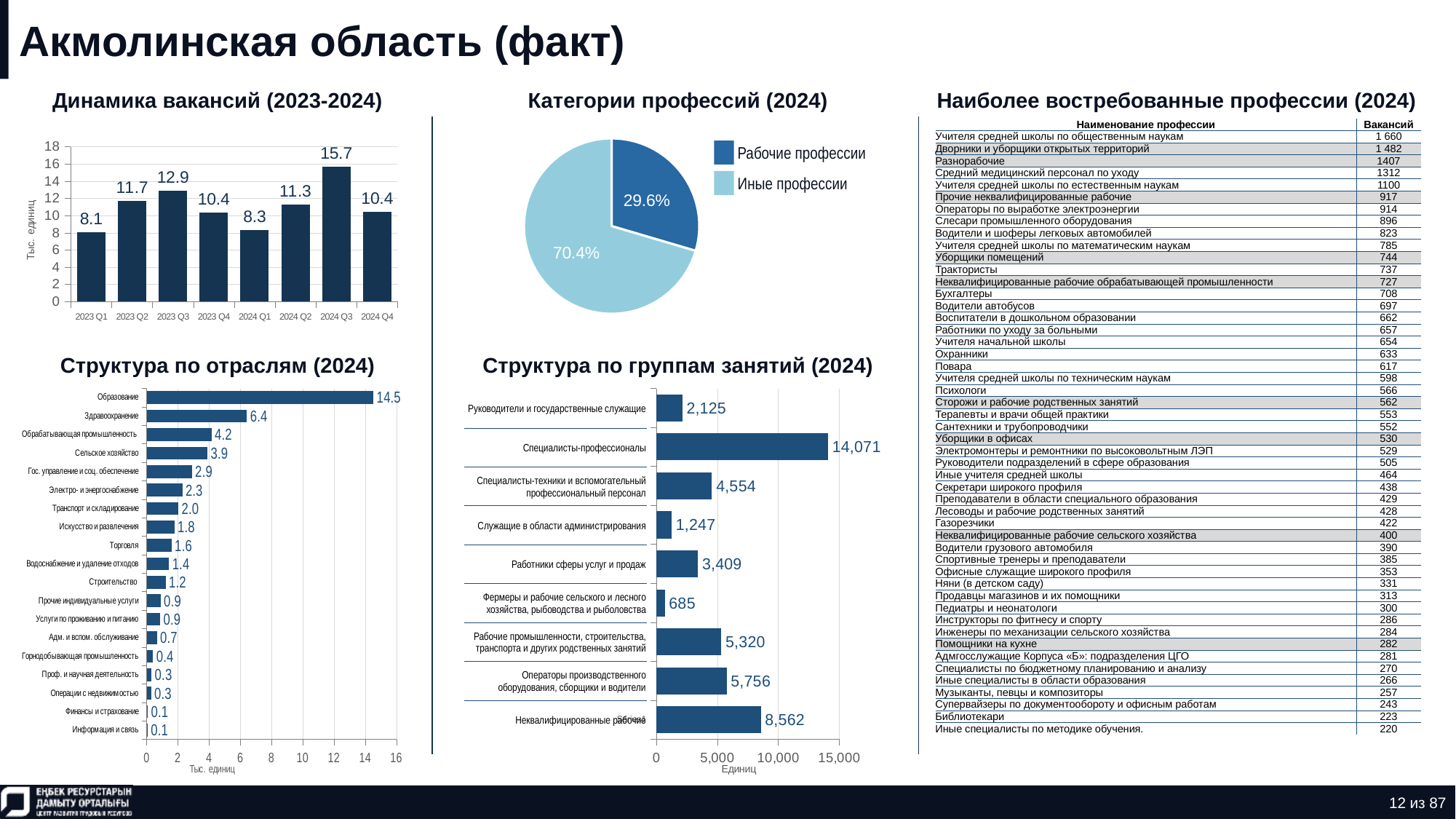
In the chart 'Динамика вакансий (2023-2024)', which quarter has the lowest value? 2023 Q1 How many series does the legend of 'Категории профессий (2024)' list? 2 In the chart 'Динамика вакансий (2023-2024)', how many quarters are plotted? 8 In the chart 'Категории профессий (2024)', what share of the pie is 'Рабочие профессии'? 29.6% In the chart 'Структура по группам занятий (2024)', which group has the lowest value? Фермеры и рабочие сельского и лесного хозяйства, рыбоводства и рыболовства What kind of chart is 'Категории профессий (2024)'? Pie chart In the chart 'Структура по отраслям (2024)', which industry has the highest value? Образование In the chart 'Динамика вакансий (2023-2024)', what is the value for 2024 Q3? 15.7 In the chart 'Структура по отраслям (2024)', which is larger: 'Сельское хозяйство' or 'Торговля'? Сельское хозяйство In the chart 'Структура по группам занятий (2024)', what is the value for 'Неквалифицированные рабочие'? 8,562 In the chart 'Структура по отраслям (2024)', what is the value for 'Здравоохранение'? 6.4 In the chart 'Динамика вакансий (2023-2024)', what is the difference between 2023 Q3 and 2023 Q1? 4.8